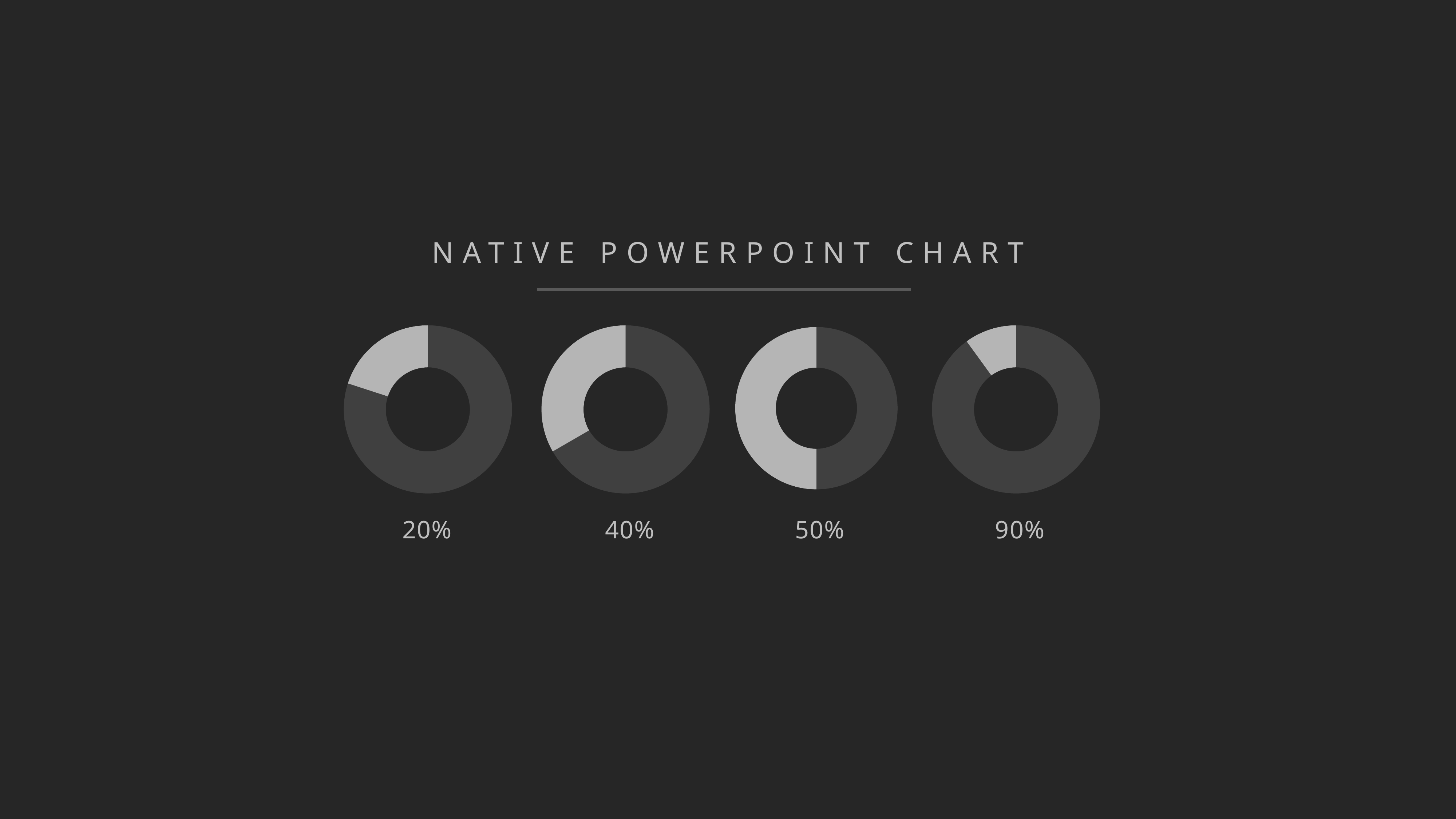
What percentage is printed under the leftmost donut chart? 20% Which donut chart has the highest percentage label? The rightmost (90%) What percentage is printed under the rightmost donut chart? 90% What kind of charts are shown on the slide? Donut charts What is the title shown above the donut charts? NATIVE POWERPOINT CHART What is the difference between the percentage labels of the rightmost and leftmost donut charts? 70% How many donut charts are shown on the slide? 4 Do the percentage labels increase or decrease from left to right across the donut charts? Increase What percentage is printed under the third donut chart from the left? 50% What percentage is printed under the second donut chart from the left? 40% Which is larger, the percentage label under the second donut chart or under the third donut chart? The third (50%) Which donut chart has the lowest percentage label? The leftmost (20%)